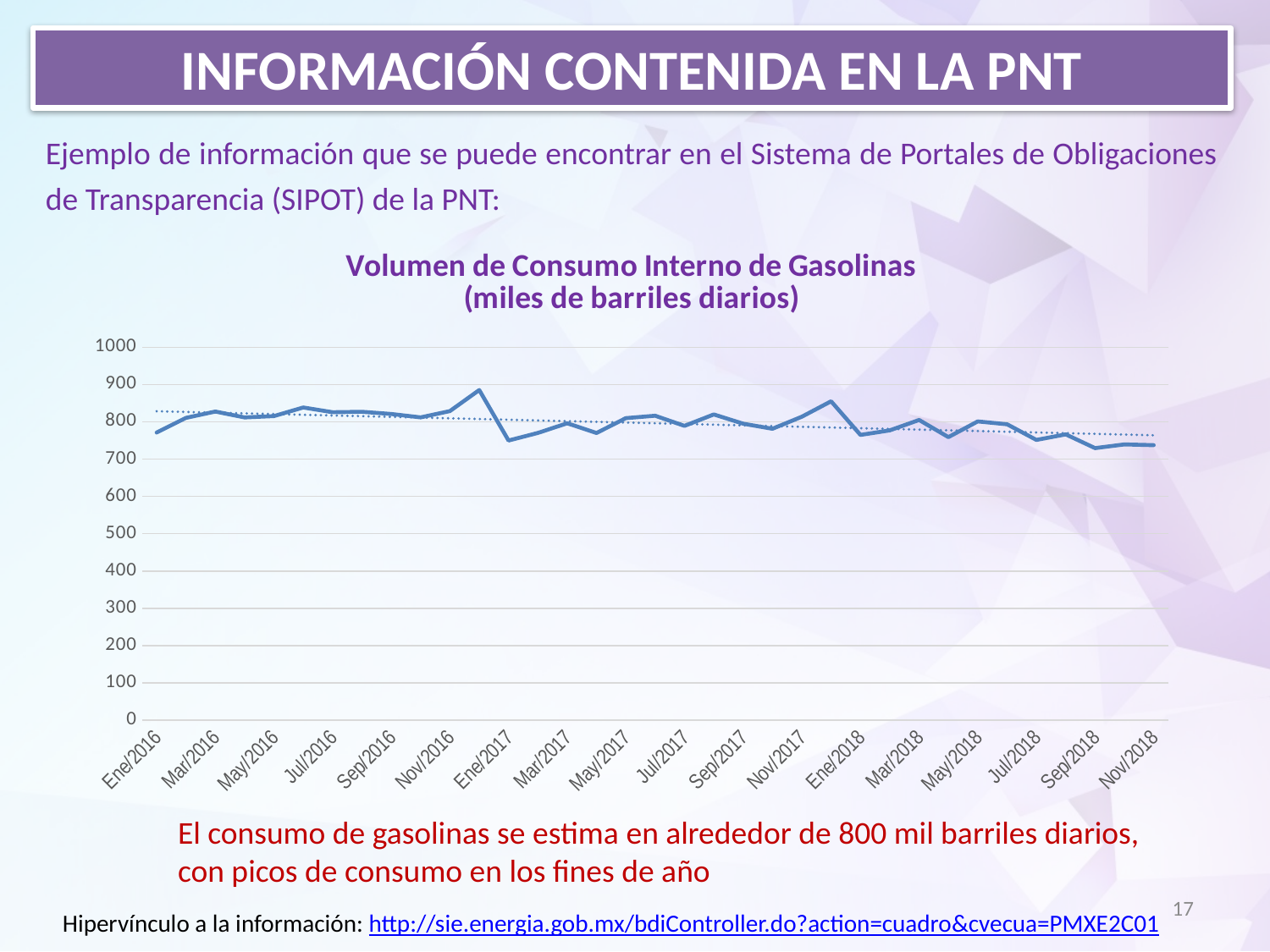
What is the highest value shown on the vertical axis of the chart? 1000 Overall, do the values rise or fall from Ene/2016 to Nov/2018? fall Which is larger, the value for Jul/2016 or the value for Nov/2018? Jul/2016 How many month labels are shown along the horizontal axis? 18 What is the title of the chart? Volumen de Consumo Interno de Gasolinas (miles de barriles diarios) Is the value for Ene/2018 greater or less than 800? less Is the value for Ene/2016 greater or less than 800? less Is the value for Jul/2016 greater or less than 800? greater What kind of chart is shown on the slide? line chart Which is larger, the value for Ene/2016 or the value for Jul/2016? Jul/2016